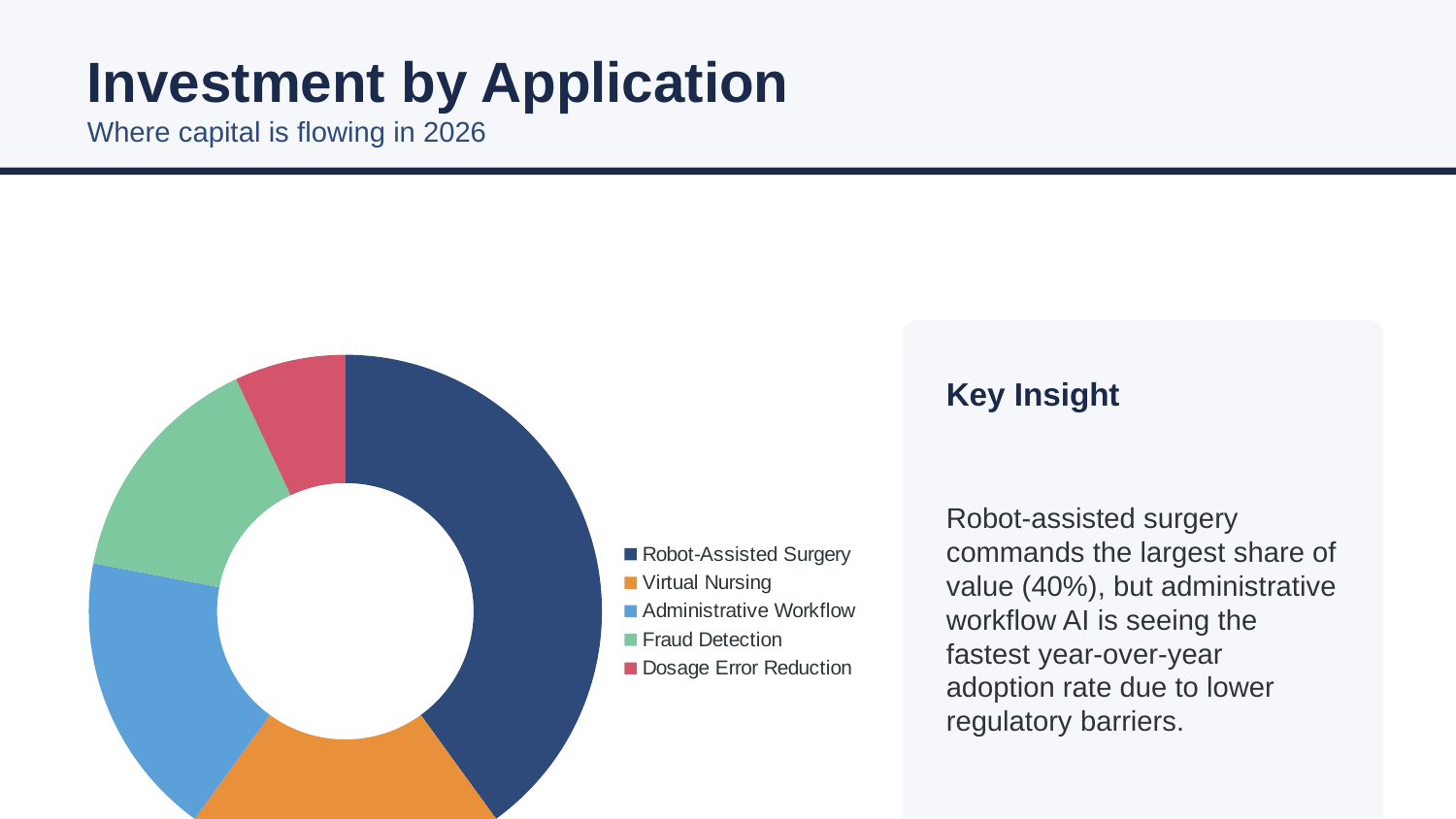
Which slice is larger, Robot-Assisted Surgery or Fraud Detection? Robot-Assisted Surgery Which slice is larger, Virtual Nursing or Dosage Error Reduction? Virtual Nursing Which category has the largest slice of the pie chart? Robot-Assisted Surgery How many entries does the legend of the pie chart list? 5 Which category has the smallest slice of the pie chart? Dosage Error Reduction What colour is the Virtual Nursing slice in the pie chart? Orange How many categories does the pie chart show? 5 Which slice is larger, Administrative Workflow or Dosage Error Reduction? Administrative Workflow What kind of chart is shown on the slide? Doughnut chart What is the title of the slide containing the pie chart? Investment by Application